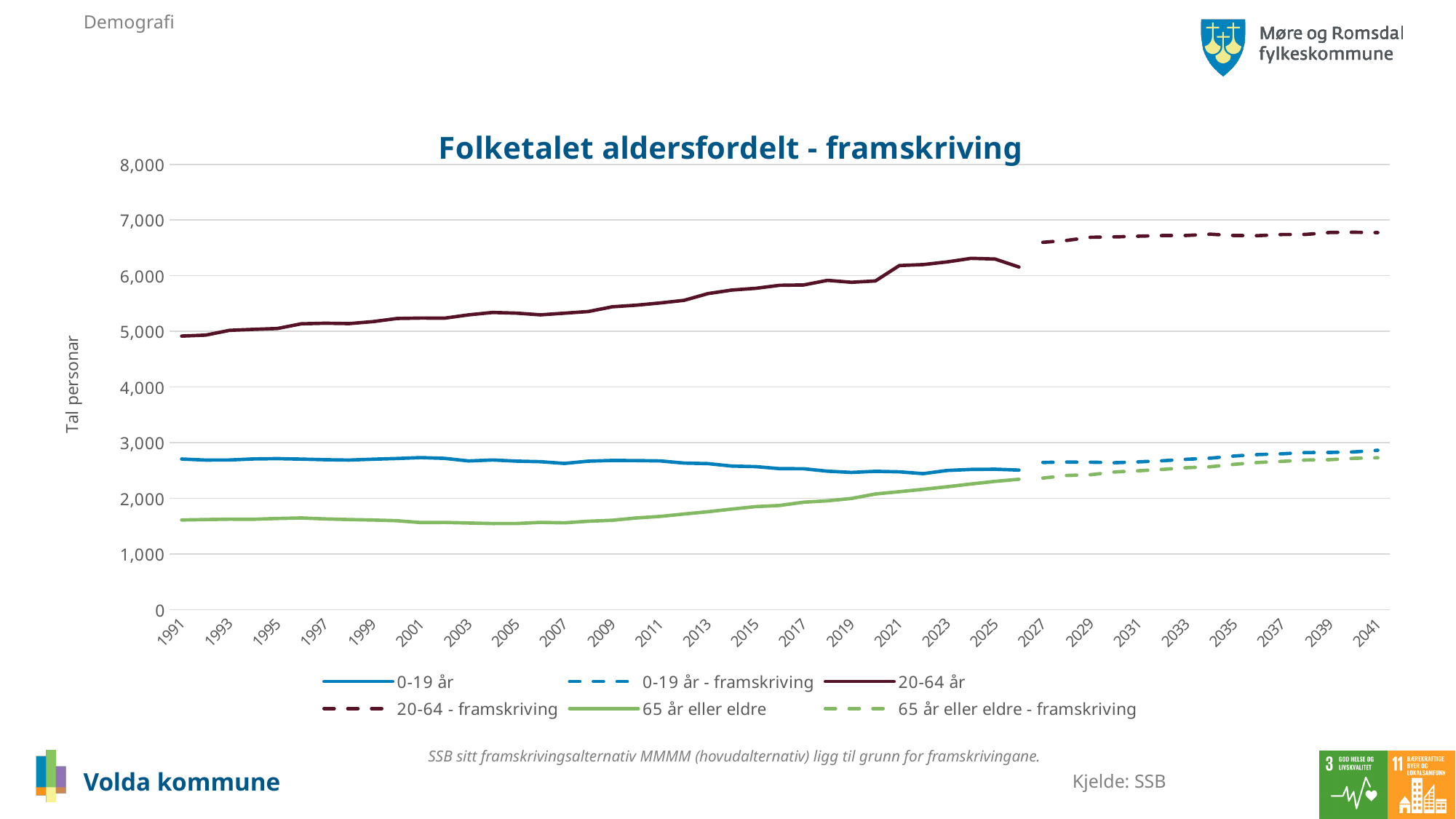
Is the value for 20-64 år in 1991 greater or less than 4,000? greater What is the label on the vertical axis? Tal personar Is the value for 20-64 - framskriving in 2041 greater or less than 6,000? greater What is the title of the chart? Folketalet aldersfordelt - framskriving Does the 65 år eller eldre series rise or fall between 2010 and 2025? rise Which series has the highest values across the whole chart? 20-64 - framskriving What kind of chart is shown on the slide? line chart How many series does the legend list? 6 Which series has the lowest values in 1991? 65 år eller eldre Is the value for 0-19 år in 2001 greater or less than 3,000? less In 2015, which is larger: 0-19 år or 65 år eller eldre? 0-19 år